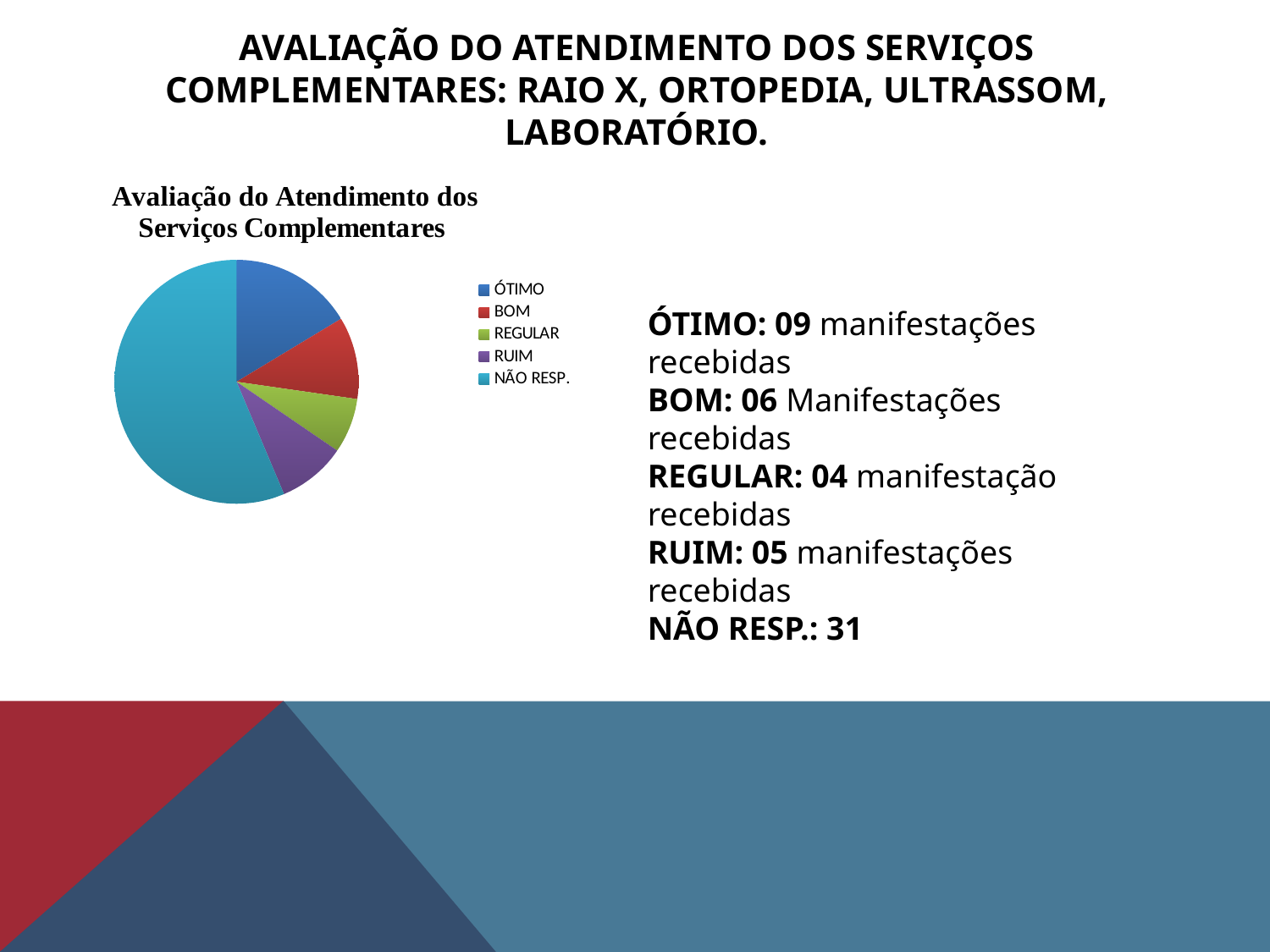
How many manifestações were received for ÓTIMO? 09 Which category has the largest slice of the pie? NÃO RESP. What kind of chart is shown on the slide? pie chart What is the title of the chart? Avaliação do Atendimento dos Serviços Complementares How many manifestações were received for BOM? 06 What is the difference between the value for NÃO RESP. and the value for ÓTIMO? 22 What is the value for NÃO RESP.? 31 Which category has the smallest slice of the pie? REGULAR Which is larger, the slice for ÓTIMO or the slice for BOM? ÓTIMO How many entries does the chart legend list? 5 What is the total of all five categories in the pie chart? 55 How many categories does the pie chart have? 5